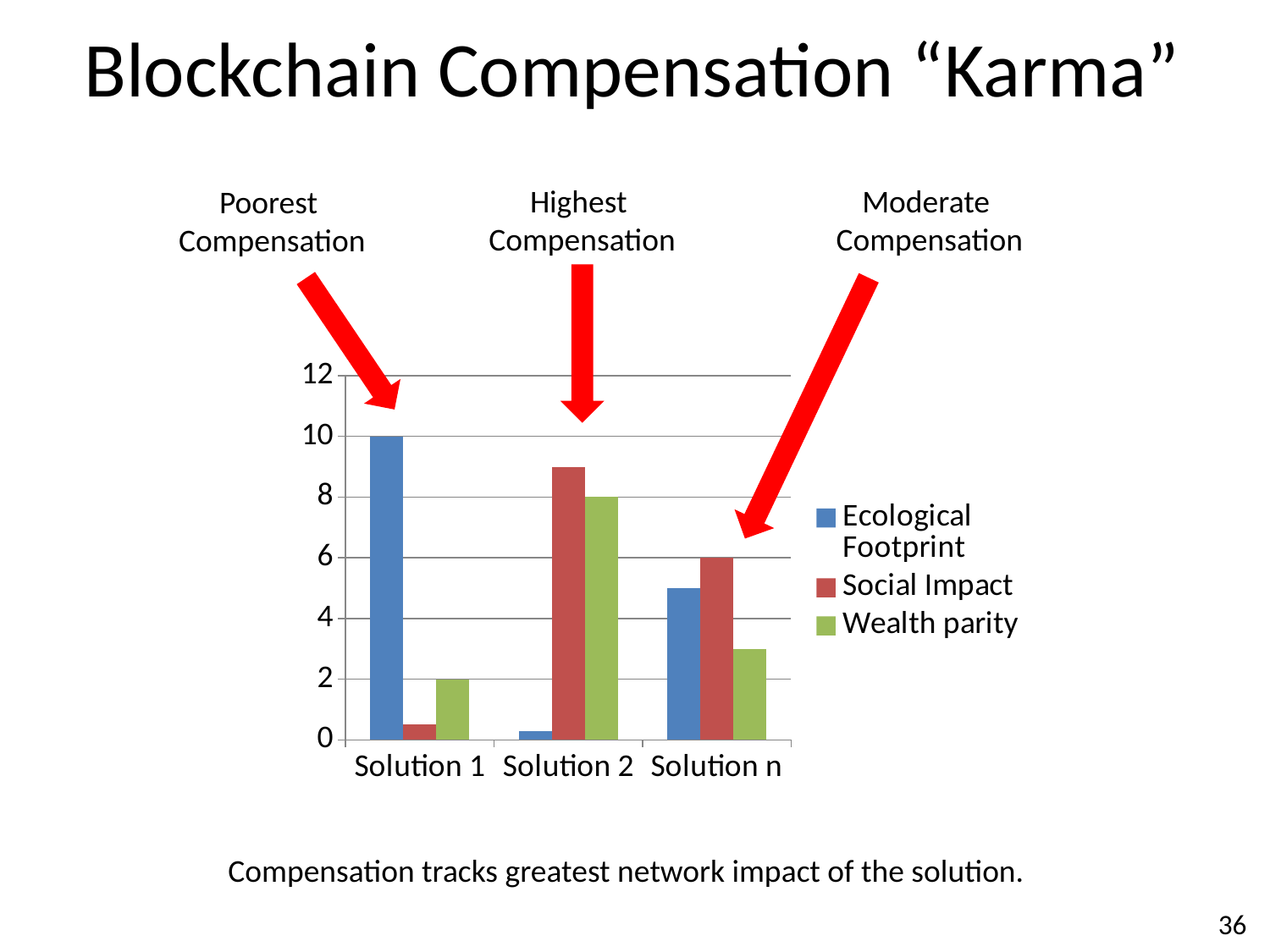
What is the Social Impact value for Solution n? 6 What is the Wealth parity value for Solution 2? 8 How many series does the legend list? 3 What is the difference between the Ecological Footprint and Wealth parity values for Solution 1? 8 Which solution has the lowest Ecological Footprint value? Solution 2 What is the Ecological Footprint value for Solution 1? 10 What is the Wealth parity value for Solution 1? 2 What kind of chart is shown on the slide? bar chart Which solution has the highest Social Impact value? Solution 2 How many solution categories are shown on the x axis? 3 Which solution is labelled as having the highest compensation? Solution 2 Is the Social Impact value for Solution 2 greater or less than 8? greater